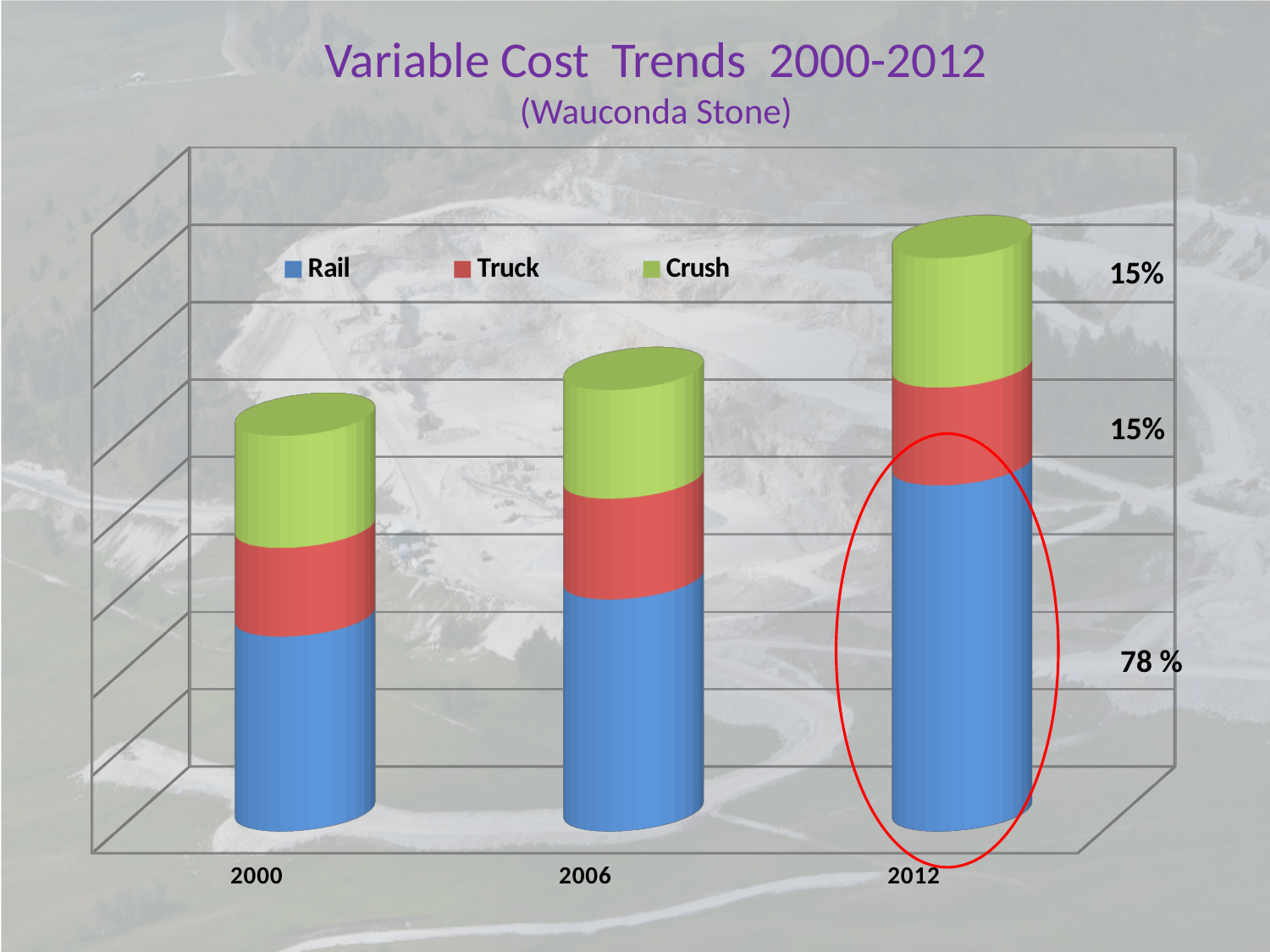
What kind of chart is shown on the slide? Stacked bar chart Which year's bar is circled in red on the slide? 2012 How many years (categories) are shown on the x axis of the chart? 3 Which year has the tallest stacked bar? 2012 Which stacked bar is taller, 2006 or 2012? 2012 Do the total bar heights rise or fall from 2000 to 2012? Rise What percentage label is shown next to the Crush segment of the 2012 bar? 15% What are the three series named in the chart's legend? Rail, Truck, Crush Which year has the shortest stacked bar? 2000 How many series does the chart's legend list? 3 What percentage label is shown next to the Rail segment of the 2012 bar? 78 % Which series forms the largest segment of the 2012 bar? Rail